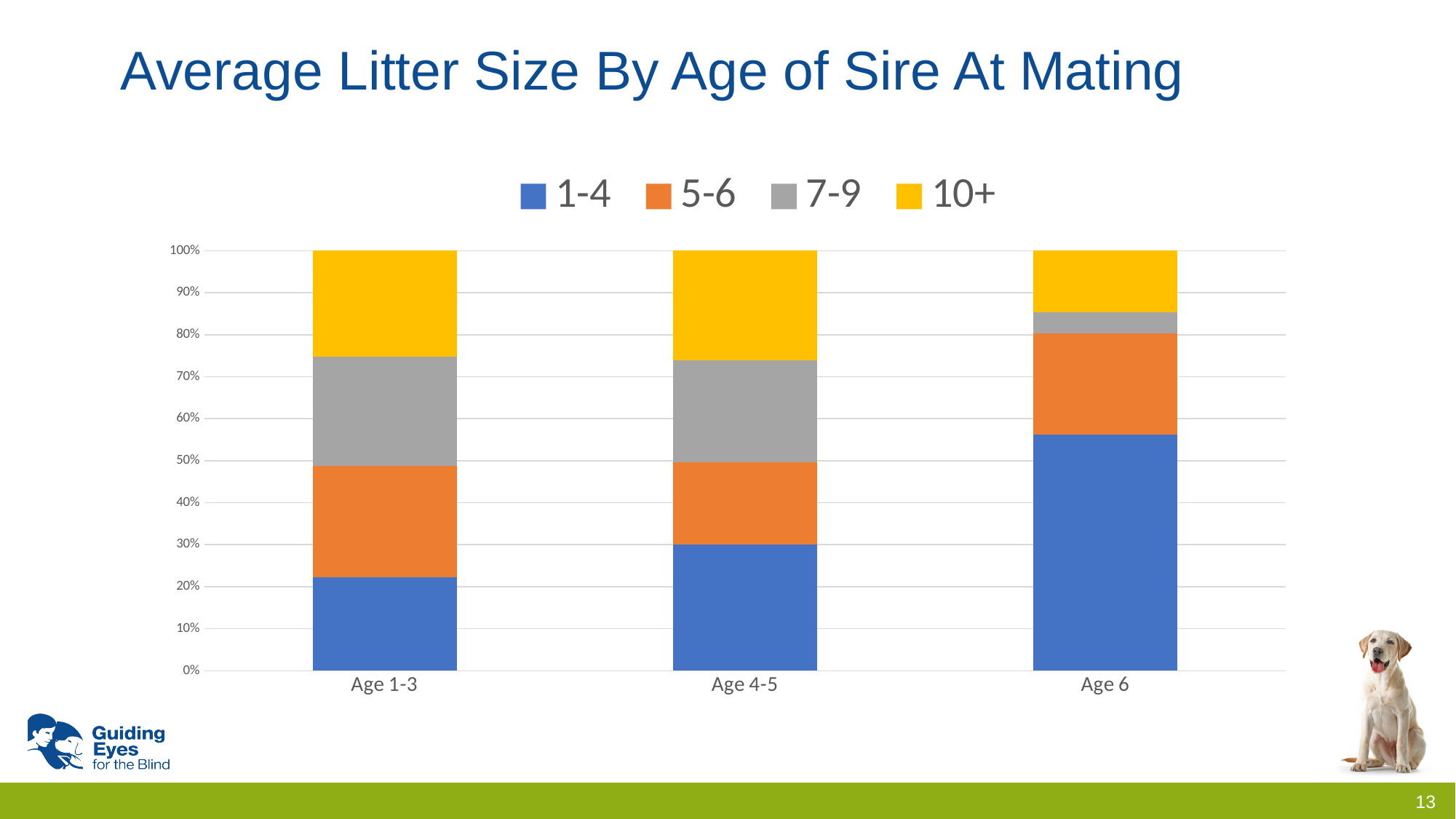
Which has the larger 1-4 share, Age 1-3 or Age 4-5? Age 4-5 Is the 7-9 share for Age 6 greater or less than 10%? less Which legend entry is shown in yellow? 10+ Does the 1-4 share rise or fall from Age 1-3 to Age 6? rise How many age categories are shown on the x axis? 3 How many series does the legend list? 4 What is the title of the chart? Average Litter Size By Age of Sire At Mating Which age group has the smallest 10+ share? Age 6 Which age group has the largest 1-4 share? Age 6 Is the 1-4 share for Age 1-3 greater or less than 30%? less What kind of chart is shown on the slide? Stacked bar chart Is the 1-4 share for Age 6 greater or less than 50%? greater